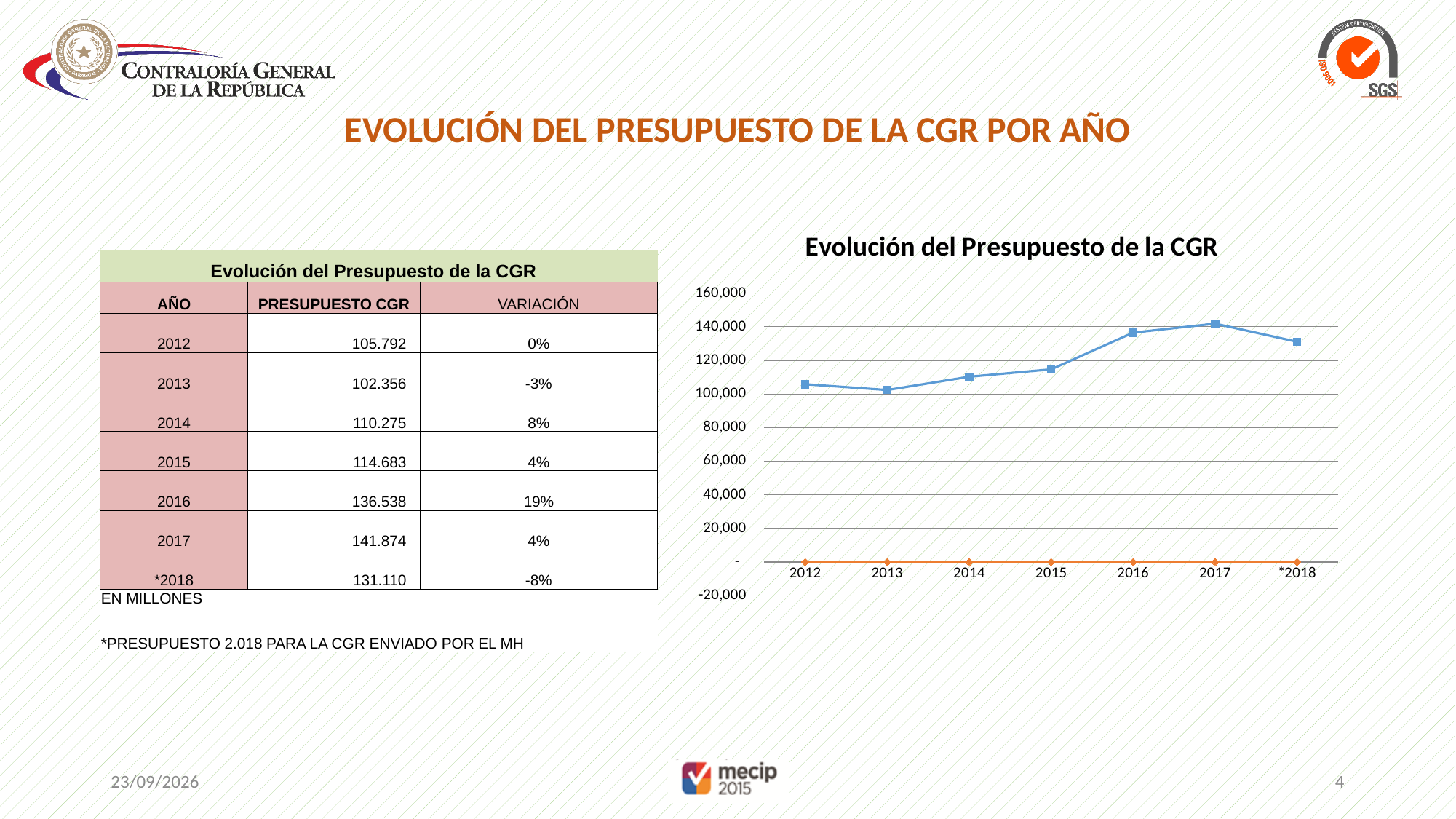
According to the table accompanying the chart, what is the PRESUPUESTO CGR for 2016? 136.538 Which is larger, the budget value for 2015 or for 2016? 2016 Which year has the lowest budget value on the chart? 2013 Which year has the highest budget value on the chart? 2017 Does the budget line rise or fall from 2013 to 2017? rise Is the budget value for 2016 greater or less than 120,000? greater How many years are plotted along the x axis of the chart? 7 Does the budget line rise or fall from 2017 to *2018? fall What kind of chart is shown on the slide? line chart Is the budget value for 2017 greater or less than 140,000? greater Is the budget value for 2013 greater or less than 120,000? less What is the title of the chart? Evolución del Presupuesto de la CGR